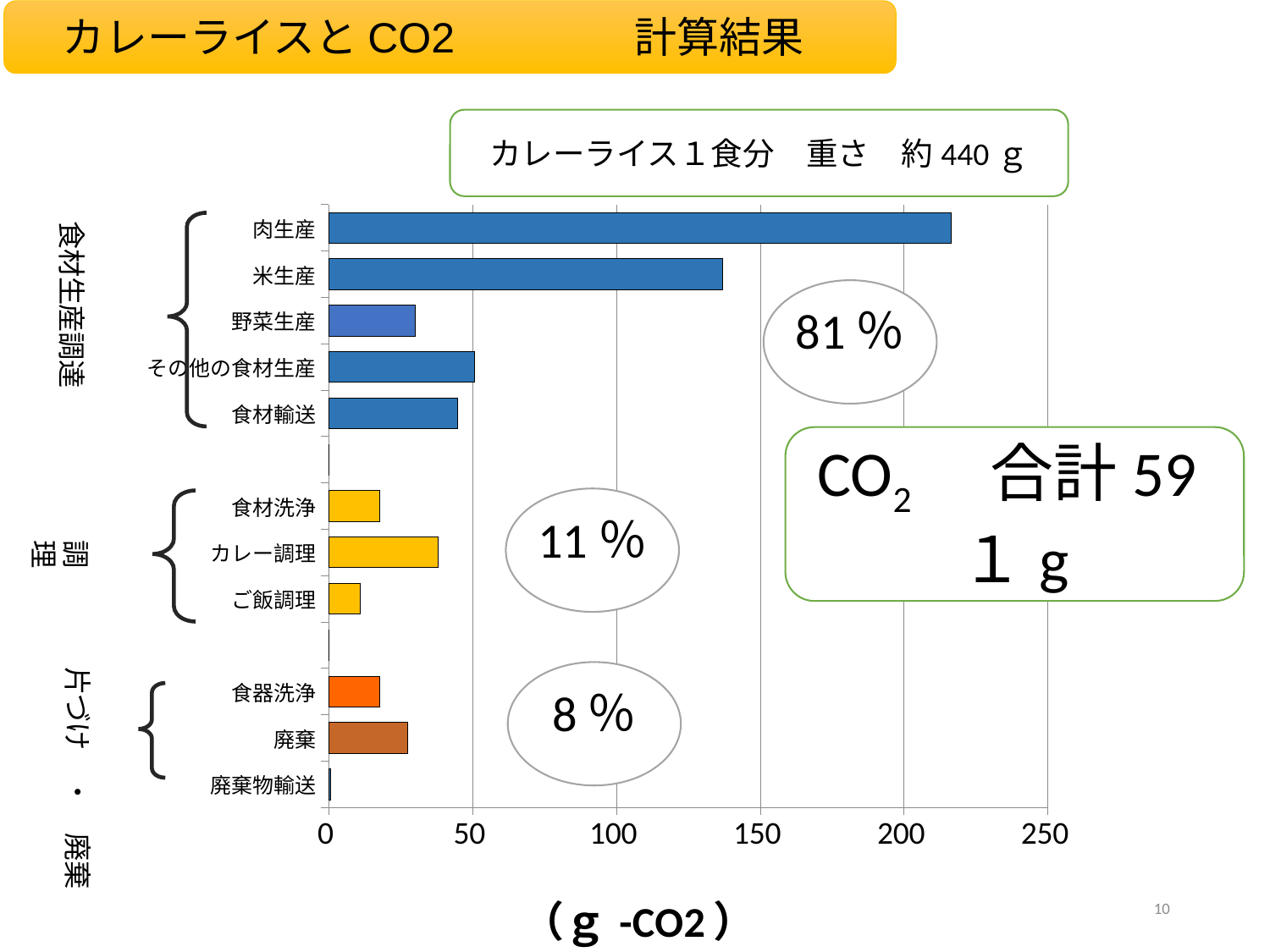
Is the value for 米生産 greater or less than 100? greater Which category has the longest bar in the chart? 肉生産 How many categories are plotted in the chart? 11 Which is larger, the value for 肉生産 or the value for 米生産? 肉生産 What kind of chart is shown on the slide? bar chart Which category has the shortest bar in the chart? 廃棄物輸送 What unit is given below the x axis of the chart? g-CO2 Is the value for カレー調理 greater or less than 50? less Which is larger, the value for カレー調理 or the value for ご飯調理? カレー調理 Is the value for 野菜生産 greater or less than 50? less What percentage is shown next to the 食材生産調達 group of bars? 81％